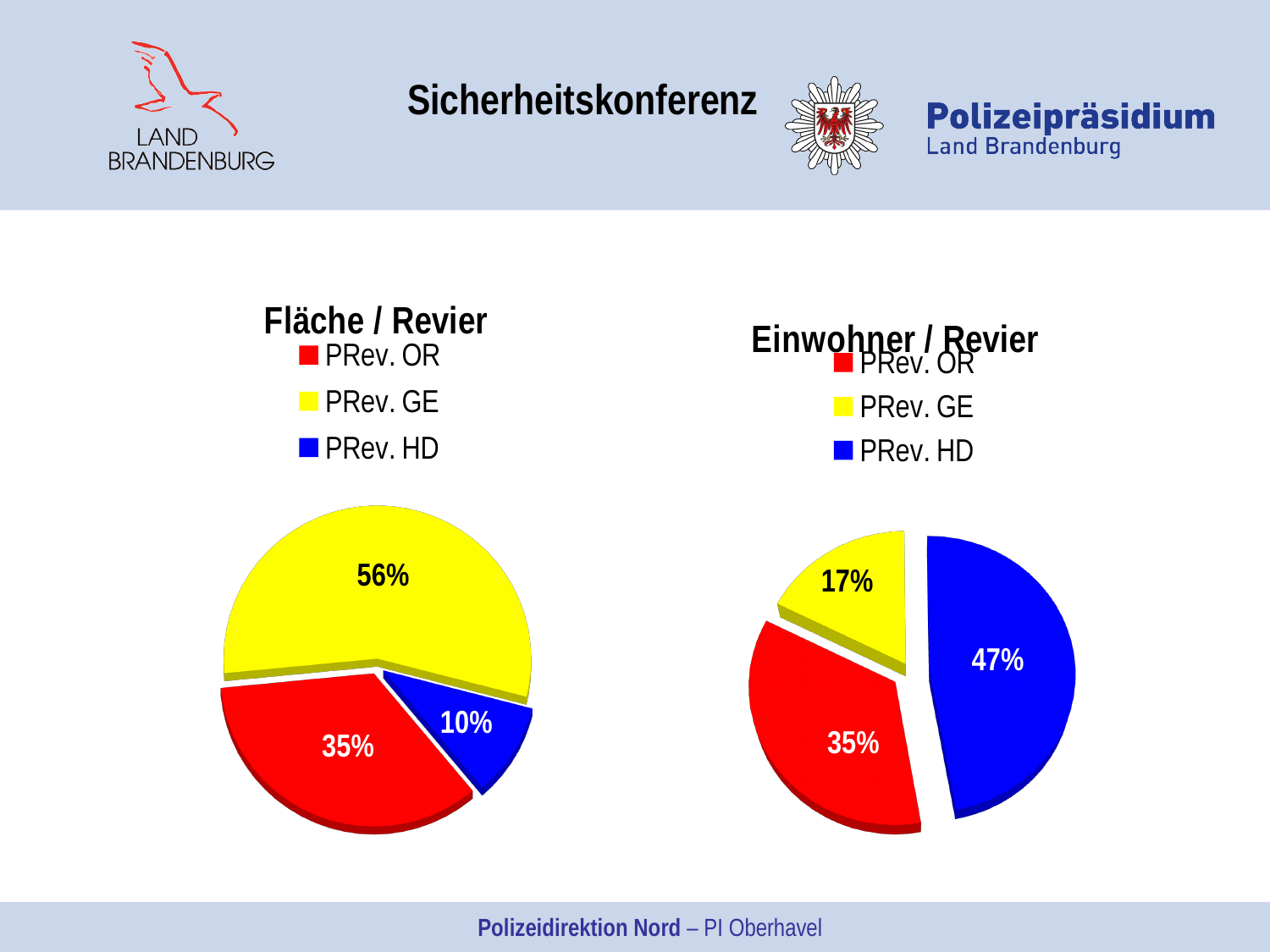
In the 'Einwohner / Revier' chart, which category has the largest slice? PRev. HD In the 'Fläche / Revier' chart, what share does PRev. GE have? 56% In the 'Fläche / Revier' chart, what share does PRev. HD have? 10% In the 'Einwohner / Revier' chart, what share does PRev. GE have? 17% In the 'Einwohner / Revier' chart, which is larger, the share of PRev. OR or PRev. HD? PRev. HD How many categories does the legend of the 'Einwohner / Revier' chart list? 3 What kind of chart is the 'Fläche / Revier' chart? Pie chart In the 'Fläche / Revier' chart, what is the difference between the shares of PRev. GE and PRev. OR? 21 percentage points In the 'Einwohner / Revier' chart, which category has the smallest slice? PRev. GE In the 'Fläche / Revier' chart, which category has the largest slice? PRev. GE